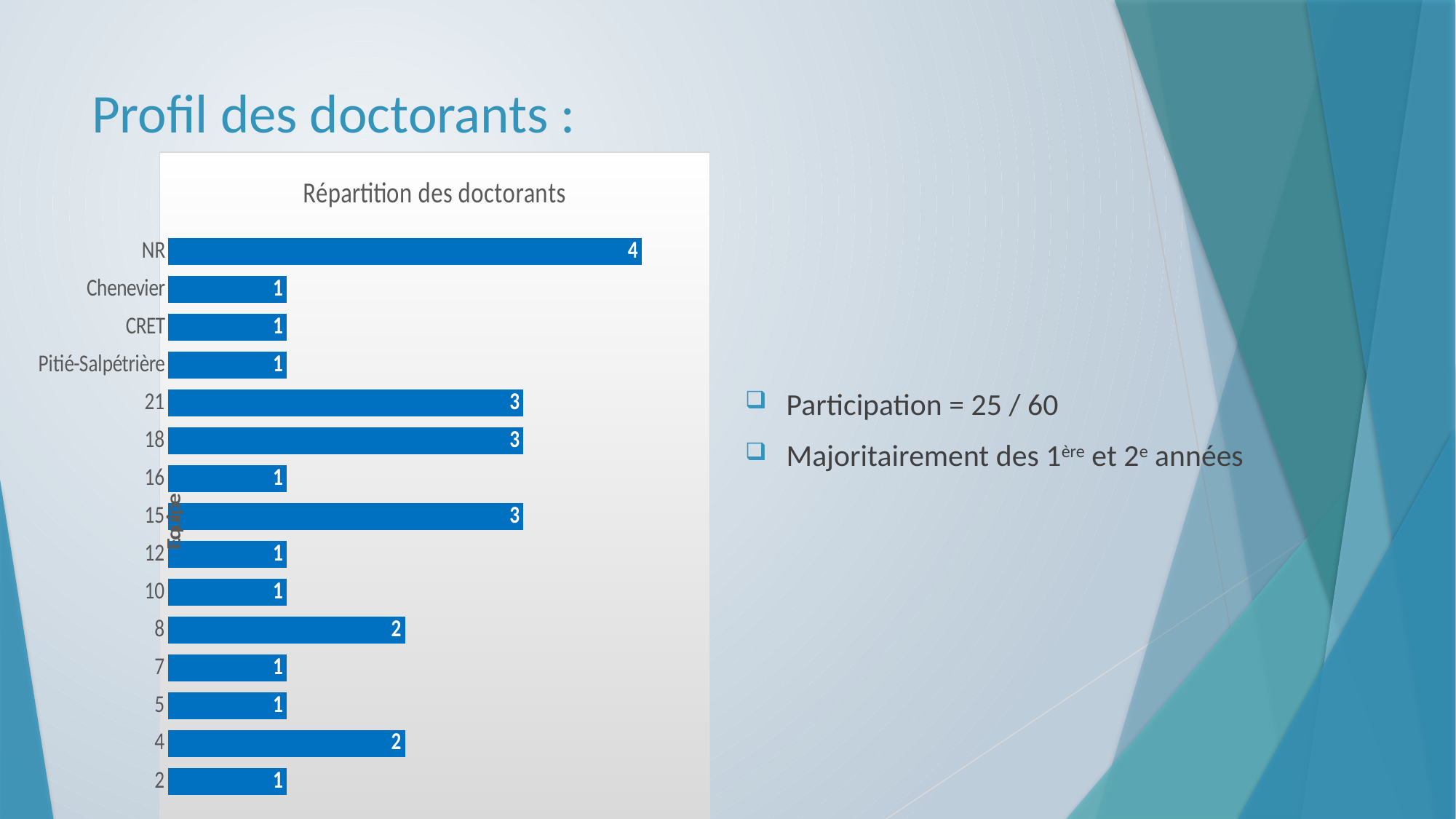
Which is larger, the value for category 18 or the value for category 16? 18 What is the value for Chenevier? 1 What is the value for NR? 4 What is the difference between the values for NR and category 15? 1 What type of chart is shown on the slide? bar chart What is the value for category 8? 2 How many categories are shown in the chart? 15 What is the label of the vertical axis? Equipe What is the title of the chart? Répartition des doctorants Which category has the highest value? NR What is the value for category 21? 3 What is the value for Pitié-Salpétrière? 1